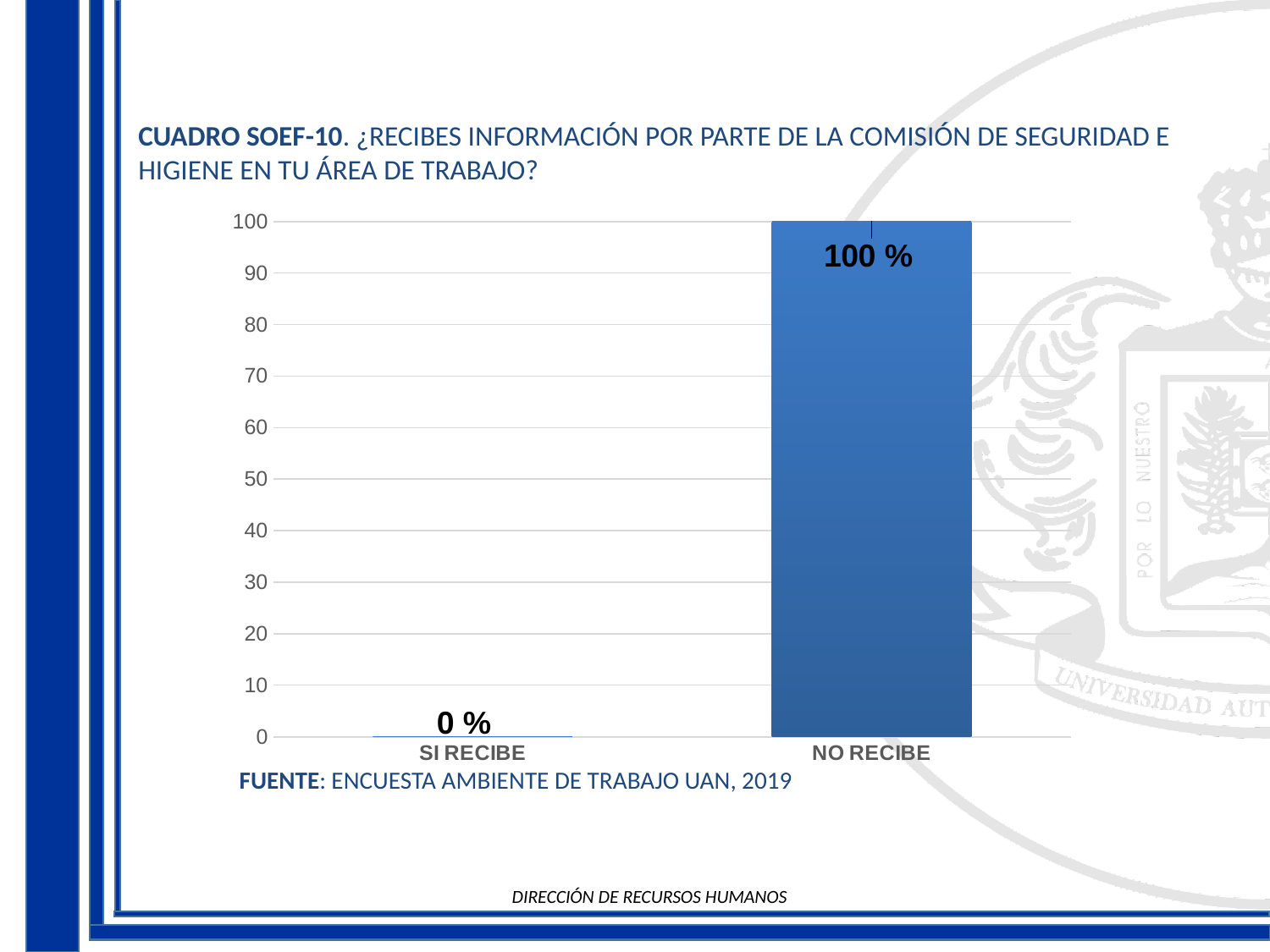
Is the value for NO RECIBE greater or less than 50? greater What kind of chart is shown on the slide? bar chart How many categories are shown on the x axis? 2 Which category has the lowest value? SI RECIBE What is the value for SI RECIBE? 0 % What source is cited below the chart? ENCUESTA AMBIENTE DE TRABAJO UAN, 2019 What is the difference between the values for NO RECIBE and SI RECIBE? 100 % Which is larger, the value for SI RECIBE or the value for NO RECIBE? NO RECIBE What is the value for NO RECIBE? 100 % What is the maximum value shown on the vertical axis? 100 Which category has the highest value? NO RECIBE